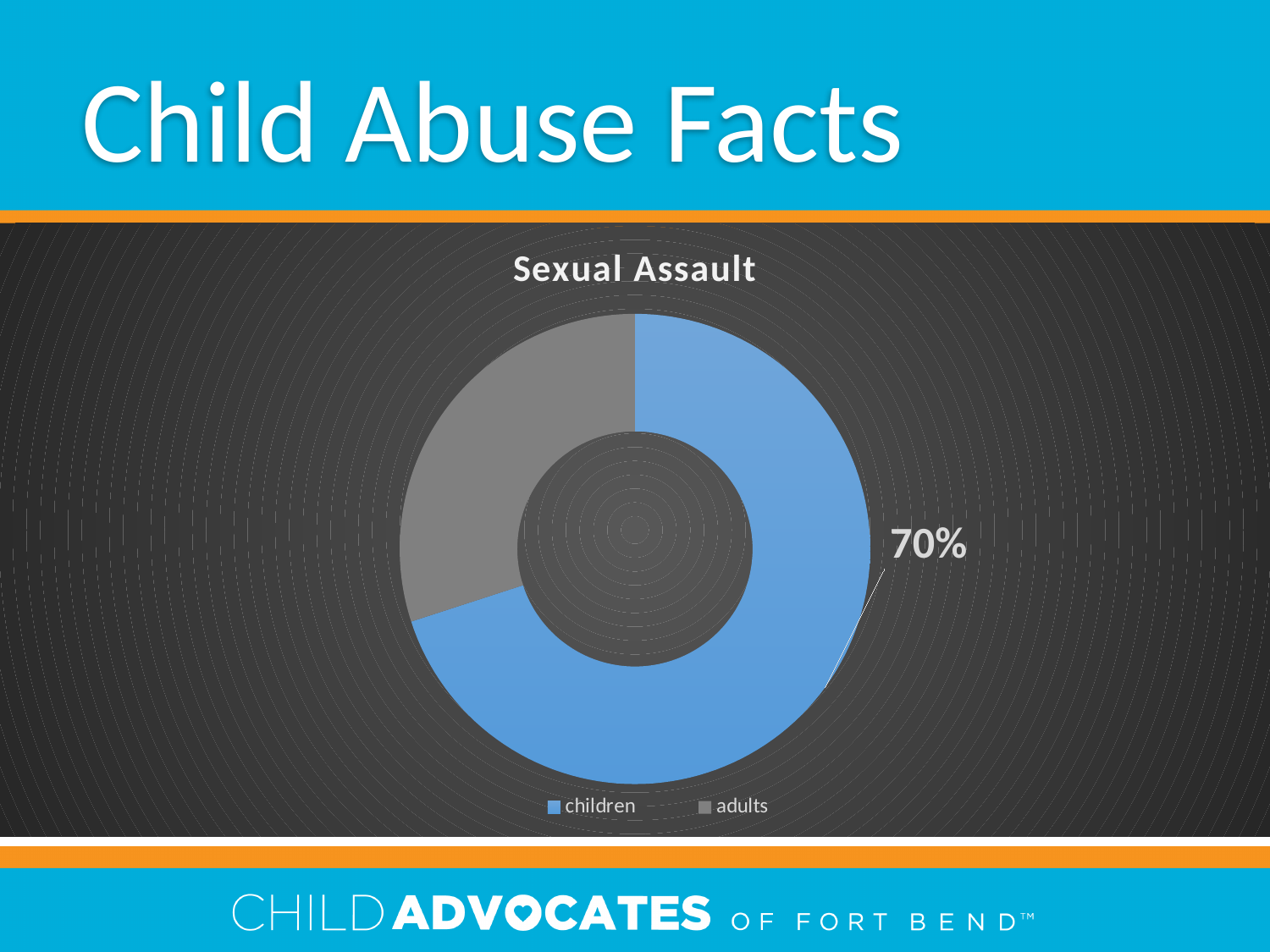
Which slice is larger, children or adults? children What share of the Sexual Assault chart does the children slice represent? 70% Which category has the largest slice in the Sexual Assault chart? children What kind of chart is shown on the slide? doughnut chart Which category has the smallest slice in the Sexual Assault chart? adults What percentage is shown for children in the Sexual Assault chart? 70% What colour represents children in the chart? blue Is the share for children greater or less than 50%? greater How many categories does the Sexual Assault chart show? 2 How many entries does the legend list? 2 What is the title of the chart? Sexual Assault